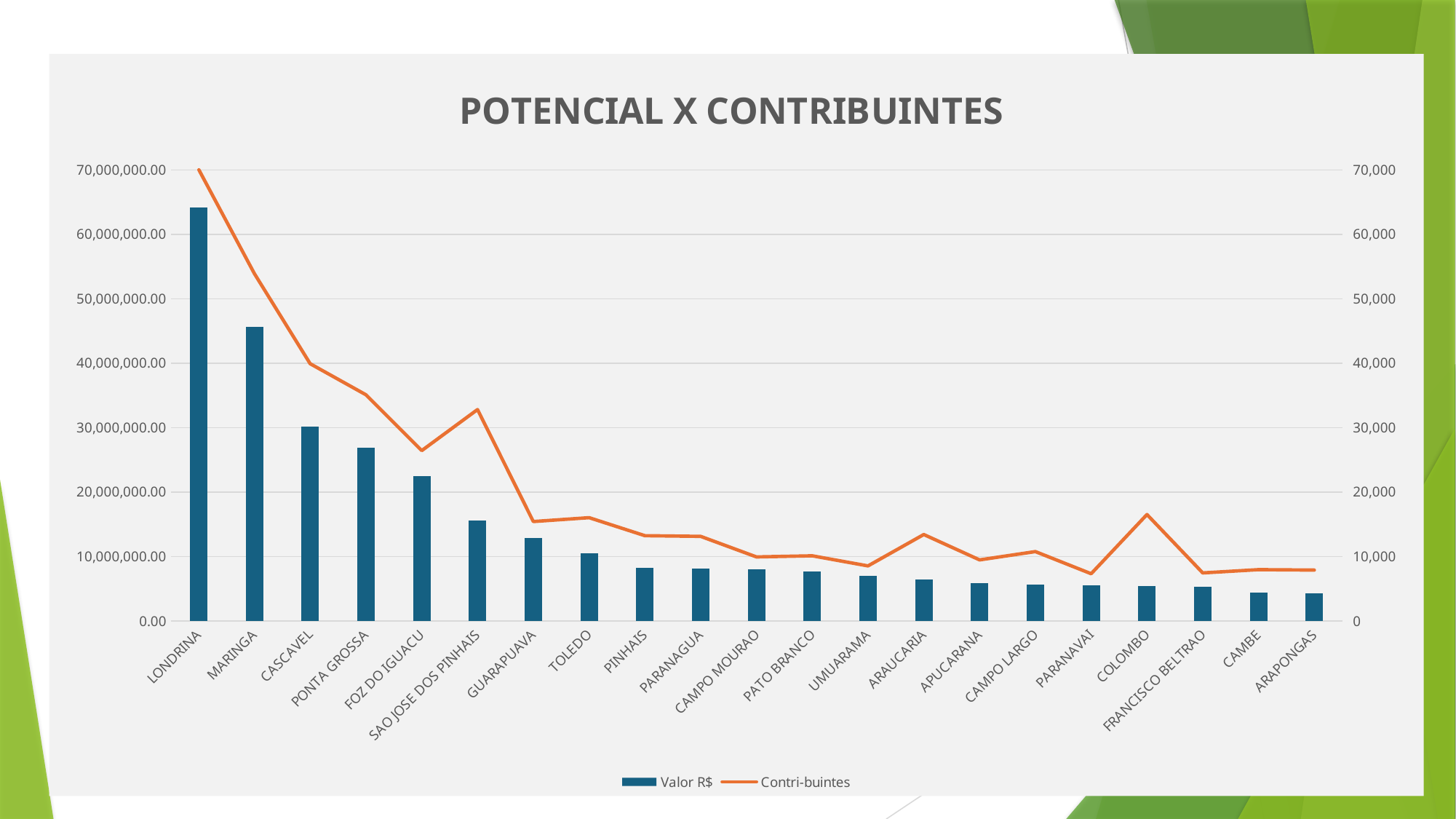
Which city has the highest Valor R$ bar? LONDRINA What kind of chart is shown on the slide? A combined bar and line chart Is the Contri-buintes value for SAO JOSE DOS PINHAIS greater or less than 30,000? greater What are the two series named in the legend? Valor R$ and Contri-buintes Is the Valor R$ for CASCAVEL greater or less than 40,000,000.00? less Which city has the highest Contri-buintes value? LONDRINA Which has the larger Contri-buintes value, COLOMBO or FRANCISCO BELTRAO? COLOMBO How many cities are shown on the x axis? 21 What is the title of the chart? POTENCIAL X CONTRIBUINTES Is the Valor R$ for LONDRINA greater or less than 60,000,000.00? greater How many series does the legend list? 2 Do the Valor R$ bars generally rise or fall from left to right along the x axis? fall